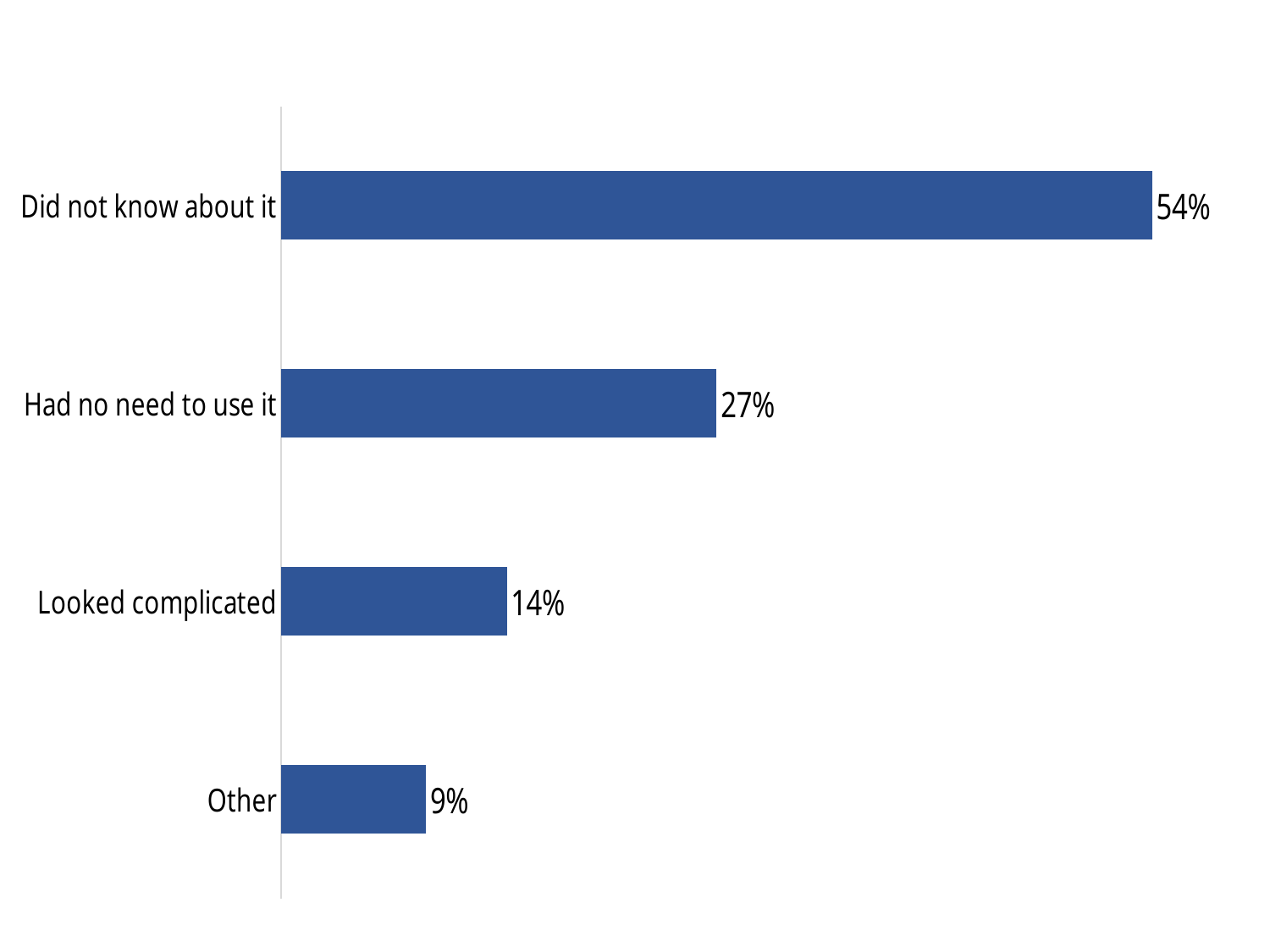
What colour are the bars in the chart? Blue What is the difference between the values for "Looked complicated" and "Other"? 5% What is the value for "Looked complicated"? 14% Which category has the highest value? Did not know about it Which is larger, the value for "Had no need to use it" or the value for "Looked complicated"? Had no need to use it What kind of chart is shown on the slide? Bar chart What is the value for "Other"? 9% What is the value for "Did not know about it"? 54% What is the difference between the values for "Did not know about it" and "Had no need to use it"? 27% What is the value for "Had no need to use it"? 27% Which category has the lowest value? Other How many categories are shown in the chart? 4